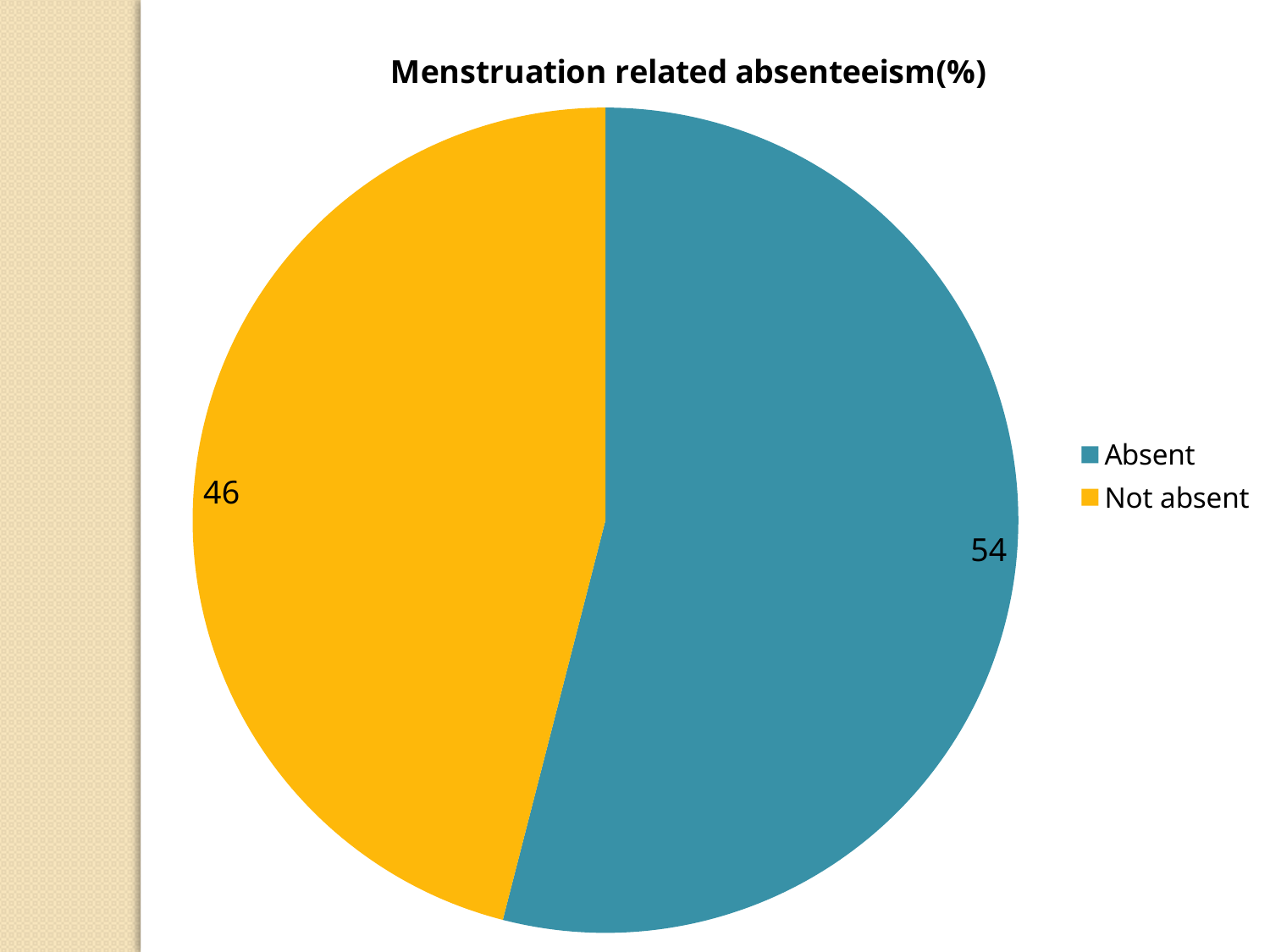
What is the value for Not absent? 46 What is the difference between the values for Absent and Not absent? 8 How many slices does the pie chart have? 2 Which is larger, Absent or Not absent? Absent What is the value for Absent? 54 Which category has the smallest slice? Not absent What kind of chart is shown on the slide? Pie chart What is the title of the chart? Menstruation related absenteeism(%) What share of the pie does the Absent slice represent? 54% What colour is the Not absent slice? Yellow Which category has the largest slice? Absent What is the total of the two slice values? 100